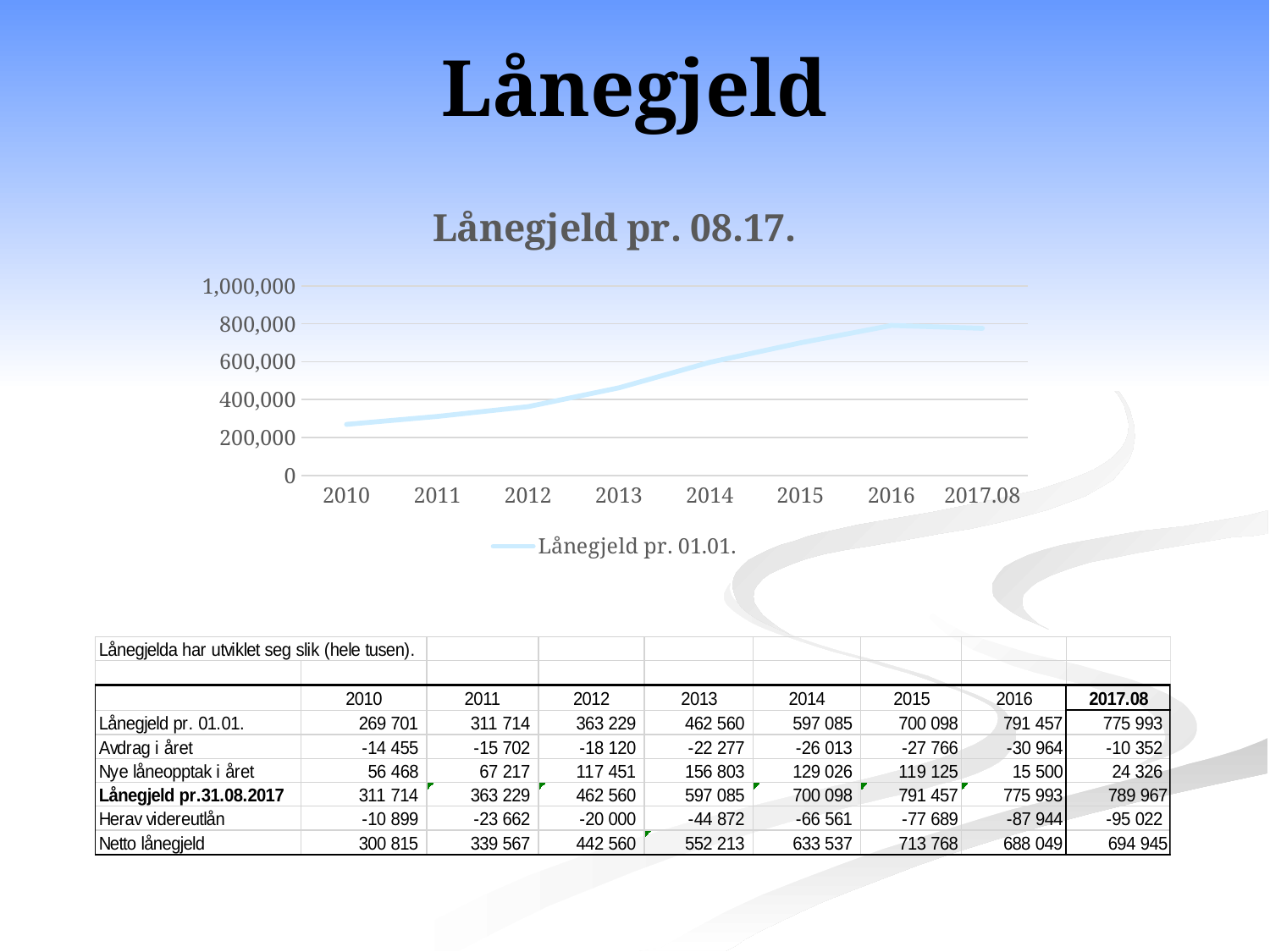
Is the value for 2010 greater or less than 400,000? less What is the title of the chart? Lånegjeld pr. 08.17. How many points are plotted along the x axis of the chart? 8 What is the name of the series shown in the chart legend? Lånegjeld pr. 01.01. Which is larger, the value for 2013 or the value for 2015? 2015 Is the value for 2015 greater or less than 600,000? greater Is the value for 2012 greater or less than 400,000? less What kind of chart is shown on the slide? line chart Which year has the lowest value in the chart? 2010 Does the line generally rise or fall from 2010 to 2016? rise How many series does the chart legend list? 1